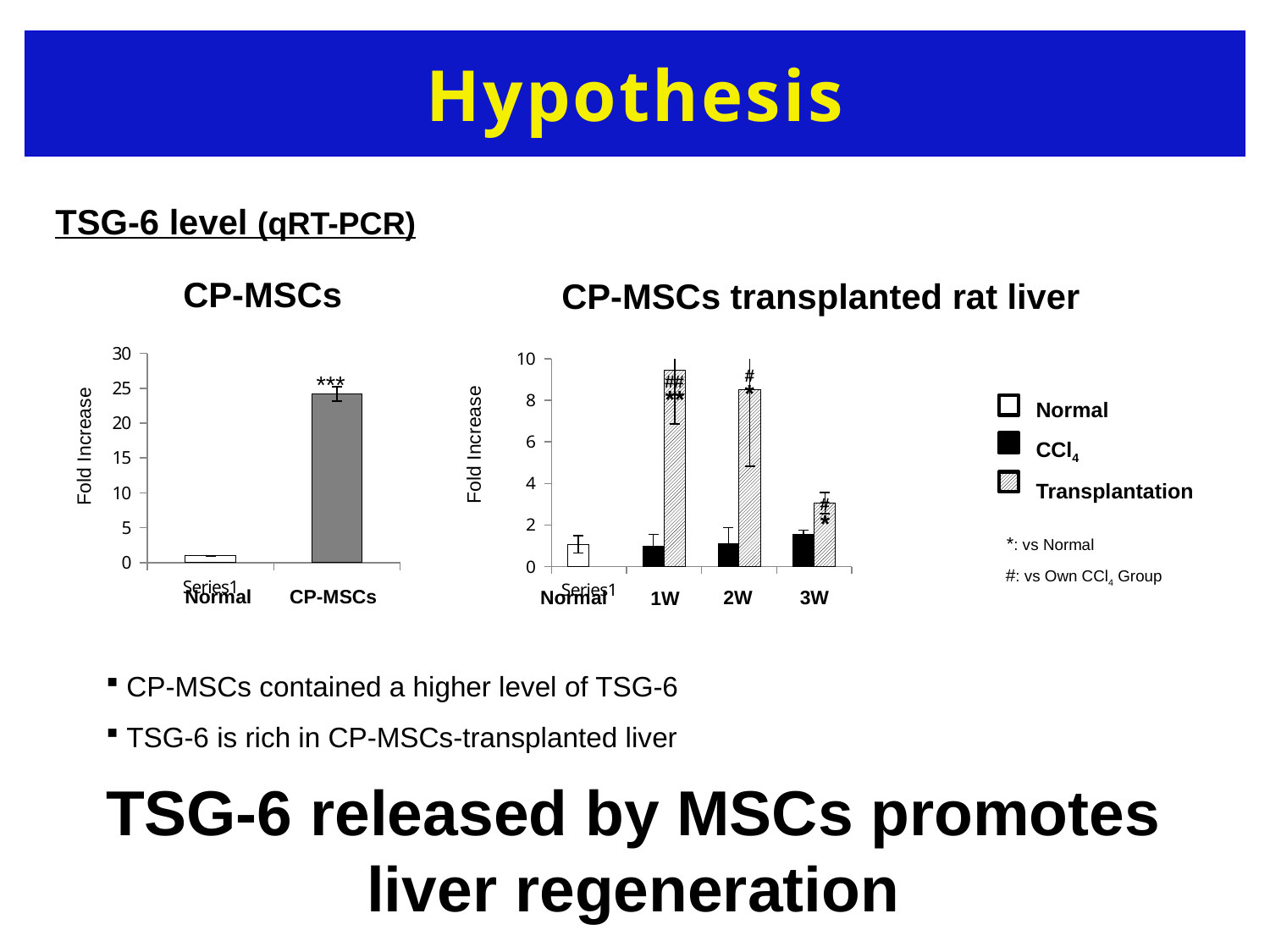
In the CP-MSCs transplanted rat liver chart, is the Transplantation value at 1W greater or less than 8? greater In the CP-MSCs chart on the left, which category has the higher Fold Increase, Normal or CP-MSCs? CP-MSCs What kind of chart is the CP-MSCs chart on the left? bar chart In the CP-MSCs chart on the left, is the value for CP-MSCs greater or less than 20? greater How many categories are shown on the x axis of the CP-MSCs transplanted rat liver chart? 4 In the CP-MSCs transplanted rat liver chart, is the Transplantation value at 3W greater or less than 4? less In the CP-MSCs transplanted rat liver chart, do the Transplantation values rise or fall from 1W to 3W? fall What is the y-axis label of the CP-MSCs transplanted rat liver chart? Fold Increase How many series does the legend list for the CP-MSCs transplanted rat liver chart? 3 In the CP-MSCs transplanted rat liver chart, at which time point is the Transplantation value lowest? 3W How many categories are shown on the x axis of the CP-MSCs chart on the left? 2